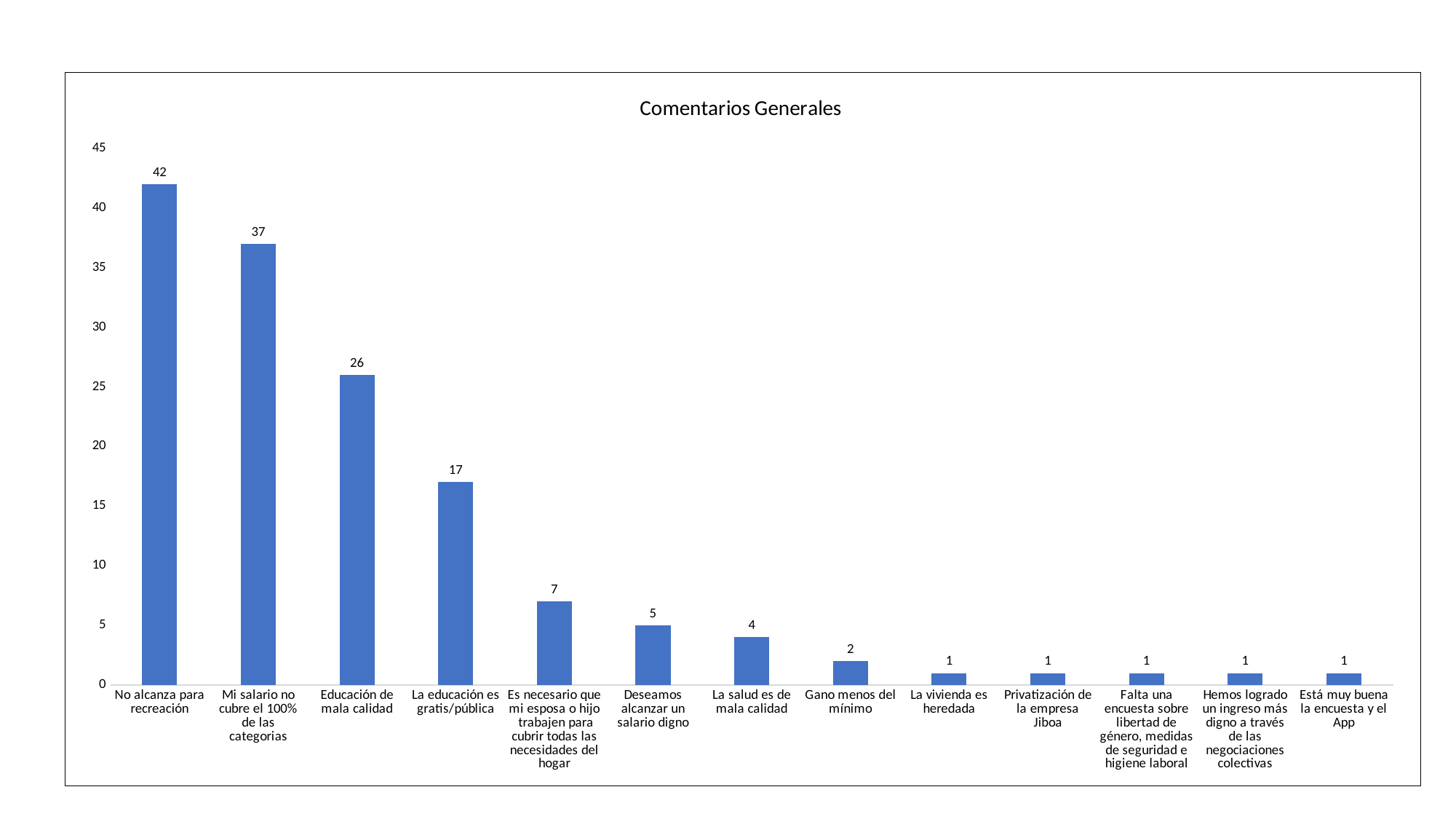
Do the values rise or fall from left to right along the x axis? Fall Which category has the highest value? No alcanza para recreación What is the value for "Deseamos alcanzar un salario digno"? 5 Which is larger, "La salud es de mala calidad" or "Gano menos del mínimo"? La salud es de mala calidad What is the value for "No alcanza para recreación"? 42 What kind of chart is shown on the slide? Bar chart What is the difference between "No alcanza para recreación" and "Mi salario no cubre el 100% de las categorias"? 5 What is the title of the chart? Comentarios Generales Is the value for "Mi salario no cubre el 100% de las categorias" greater or less than 35? greater What is the value for "Educación de mala calidad"? 26 What is the difference between "Educación de mala calidad" and "La educación es gratis/pública"? 9 How many categories are shown in the chart? 13